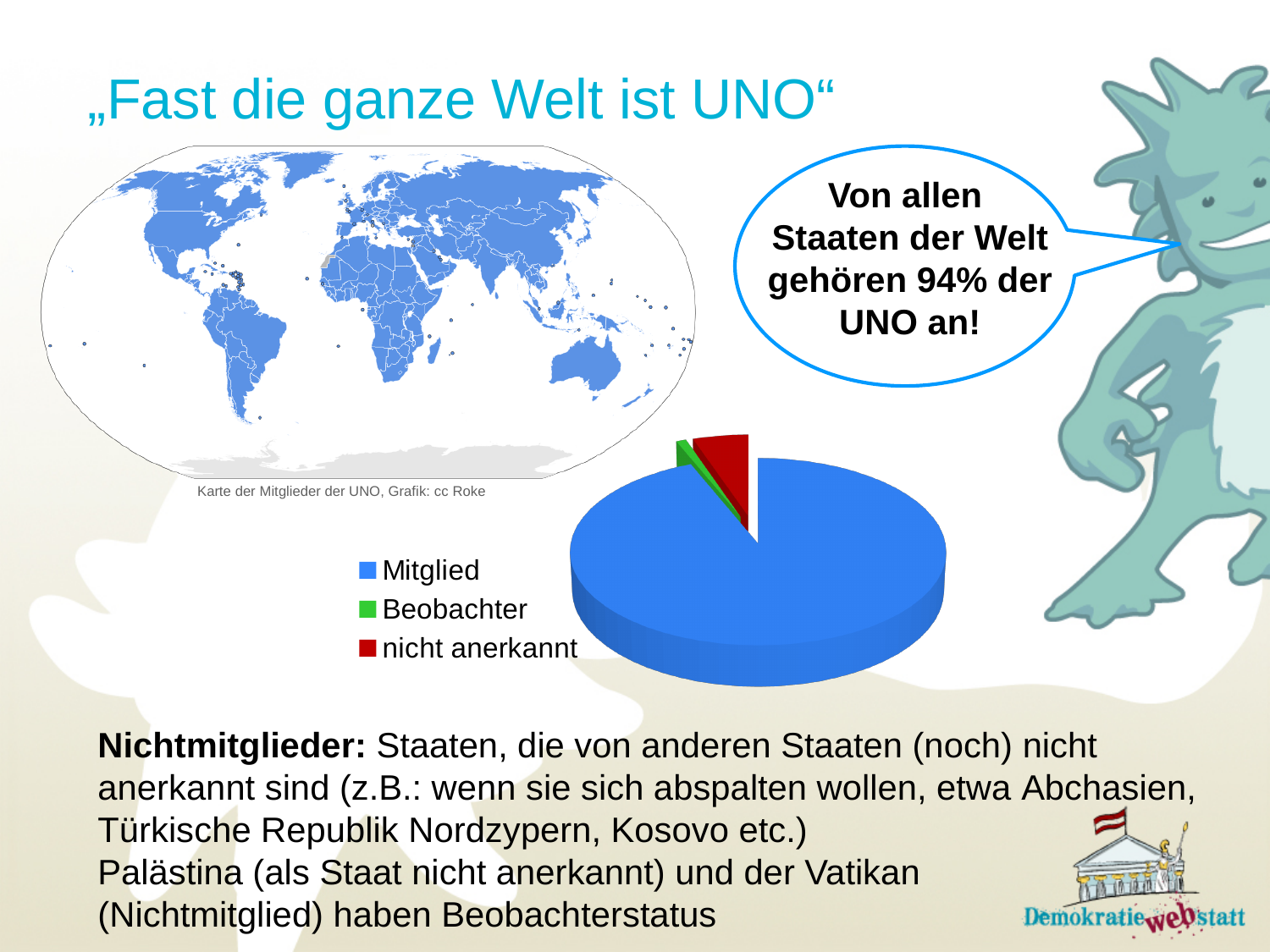
How many slices does the pie chart have? 3 What colour is the Mitglied slice in the pie chart? blue Does the Mitglied slice make up more or less than half of the pie chart? more Which slice is larger in the pie chart, Mitglied or nicht anerkannt? Mitglied Which slice is larger in the pie chart, Mitglied or Beobachter? Mitglied Which category has the largest slice in the pie chart? Mitglied Which category is shown in red in the pie chart? nicht anerkannt How many entries does the legend of the pie chart list? 3 What kind of chart is shown on the slide? pie chart